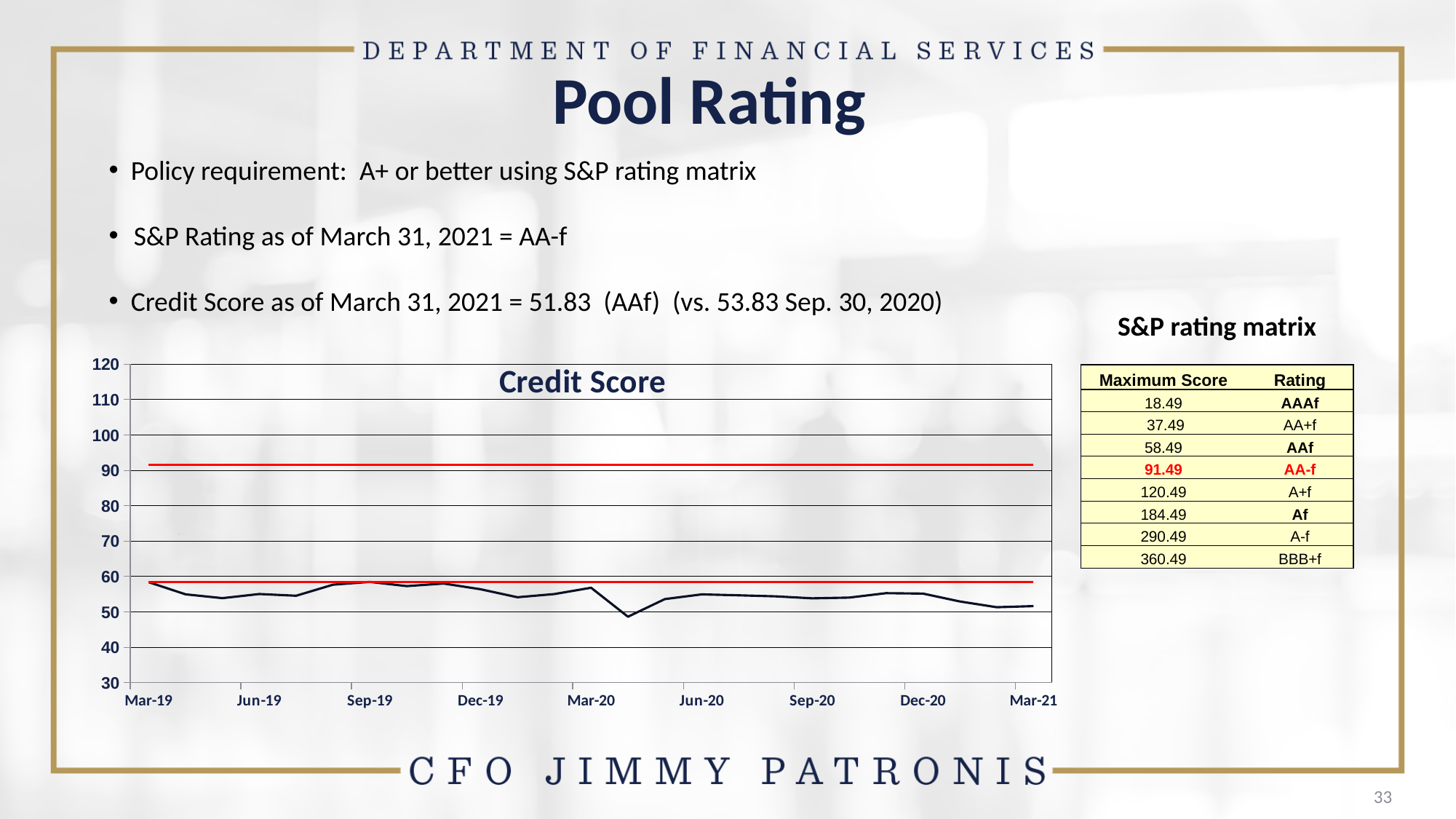
What is the title of the chart on the slide? Credit Score Is the value for Mar-21 in the Credit Score chart greater or less than 60? less Is the value for Dec-20 in the Credit Score chart greater or less than 50? greater How many date labels are shown on the x axis of the Credit Score chart? 9 Is the value for Mar-19 in the Credit Score chart greater or less than 50? greater What kind of chart is the Credit Score chart? line chart Which is higher in the Credit Score chart, the value for Mar-19 or the value for Mar-21? Mar-19 What is the highest value shown on the y axis of the Credit Score chart? 120 Does the credit score line rise or fall overall from Mar-19 to Mar-21? fall What is the first date label on the x axis of the Credit Score chart? Mar-19